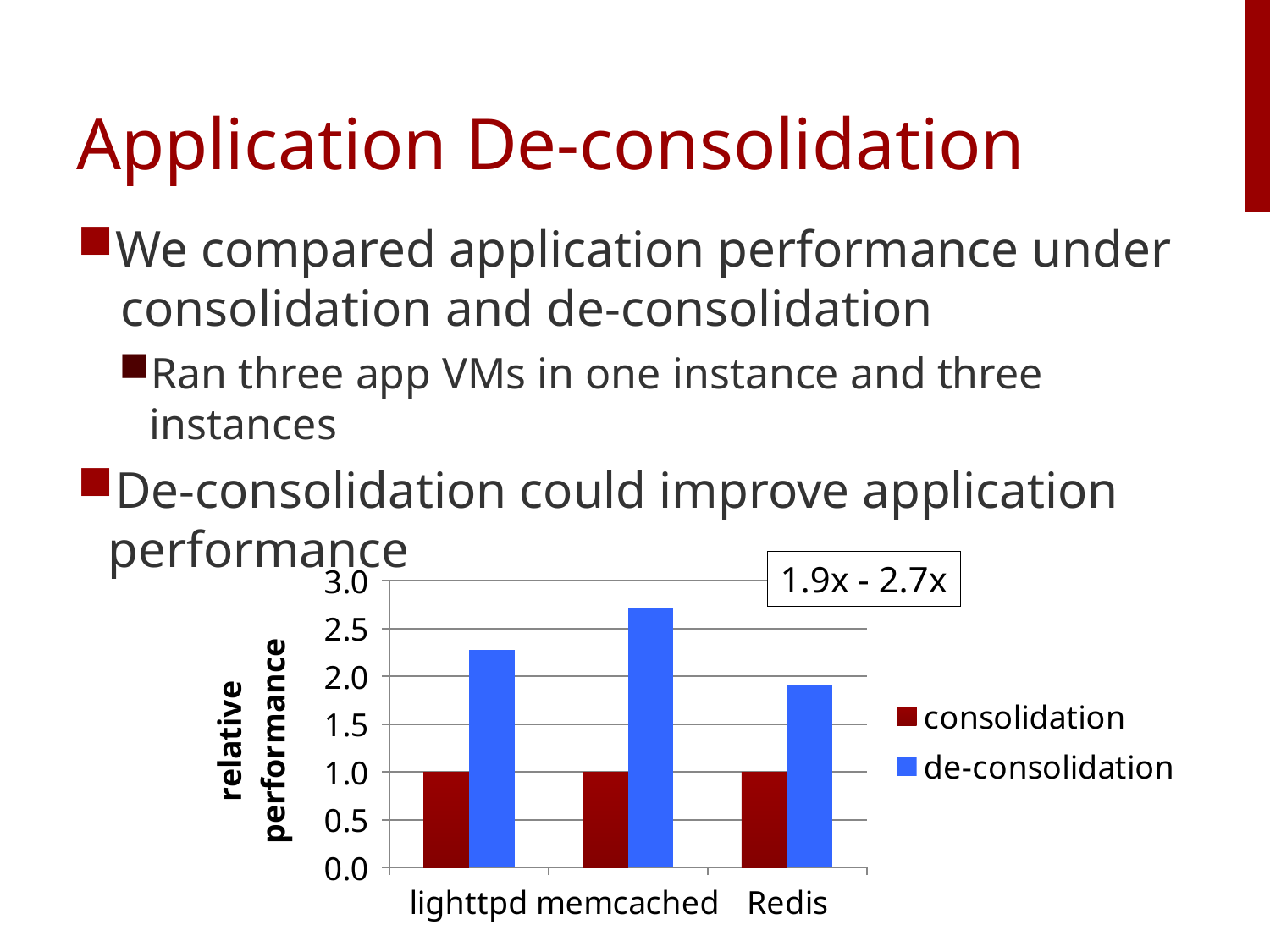
Is the de-consolidation value for lighttpd greater or less than 2.0? greater Is the de-consolidation value for Redis greater or less than 1.5? greater Which category has the lowest de-consolidation value? Redis Is the de-consolidation value for memcached greater or less than 2.5? greater What kind of chart is shown on the slide? bar chart How many series does the chart legend list? 2 Which category has the highest de-consolidation value? memcached What is the label on the y axis of the chart? relative performance How many categories are shown on the x axis of the chart? 3 Which is larger: the de-consolidation value for lighttpd or for Redis? lighttpd What is the relative performance value for Redis under consolidation? 1.0 What is the relative performance value for lighttpd under consolidation? 1.0